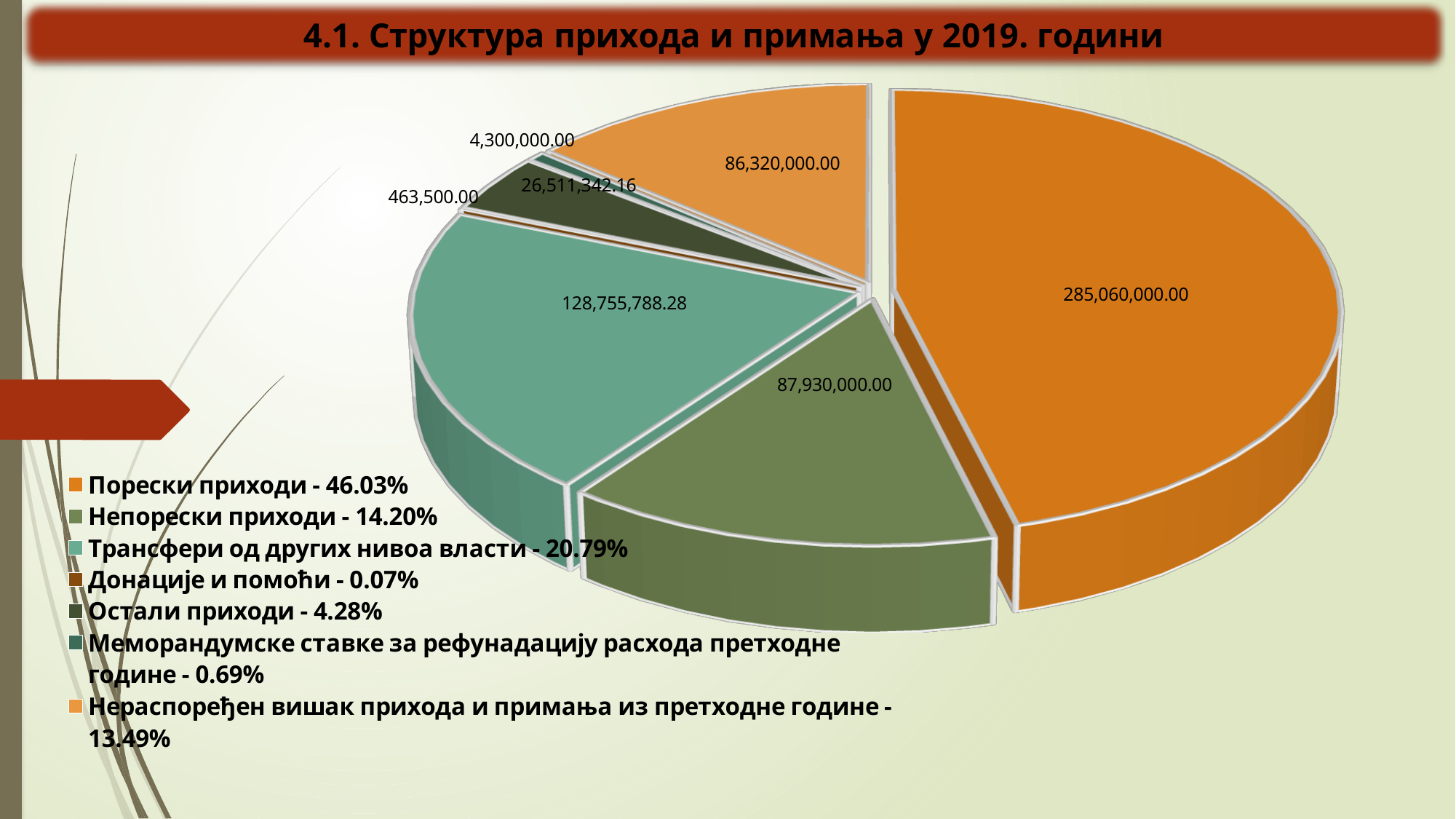
How many categories does the pie chart have? 7 What is the value of the Порески приходи slice? 285,060,000.00 Which category has the smallest slice of the pie? Донације и помоћи What is the title of the chart? 4.1. Структура прихода и примања у 2019. години What is the value of the Трансфери од других нивоа власти slice? 128,755,788.28 What is the value of the Остали приходи slice? 26,511,342.16 Which category has the largest slice of the pie? Порески приходи Which is larger: Нераспоређен вишак прихода и примања из претходне године or Непорески приходи? Непорески приходи What type of chart is shown on the slide? pie chart What is the difference between the Порески приходи value and the Непорески приходи value? 197,130,000.00 What is the value of the Непорески приходи slice? 87,930,000.00 What share of the pie does Трансфери од других нивоа власти represent, according to the legend? 20.79%